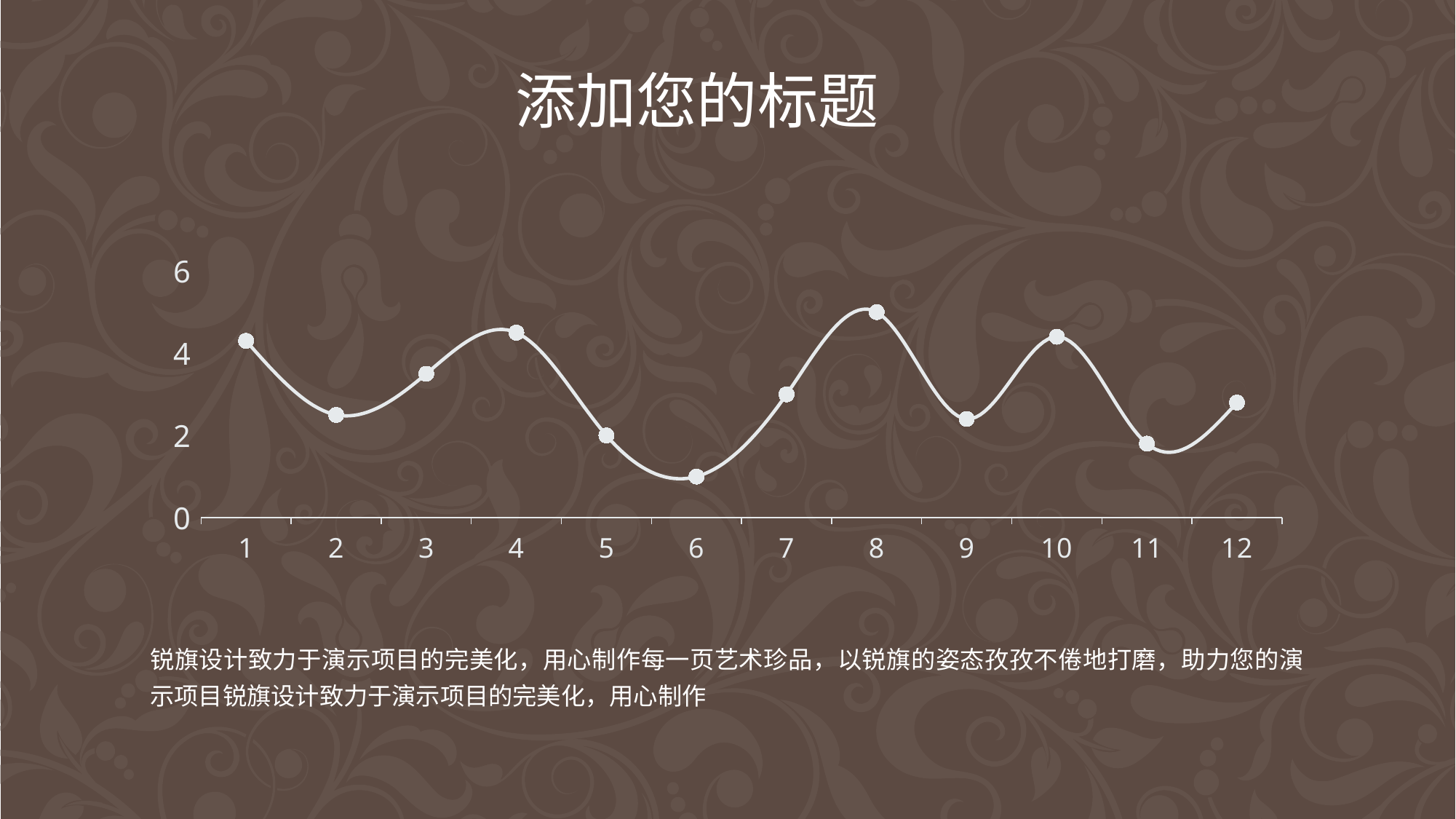
Is the value for category 2 greater or less than 2? greater Which has the larger value, category 10 or category 11? 10 Which has the larger value, category 4 or category 5? 4 Do the values rise or fall from category 6 to category 8? rise Is the value for category 6 greater or less than 2? less Which category on the x axis has the lowest value? 6 Which category on the x axis has the highest value? 8 What kind of chart is shown on the slide? line chart What is the title shown above the chart? 添加您的标题 How many data points are plotted on the line chart? 12 Is the value for category 8 greater or less than 4? greater